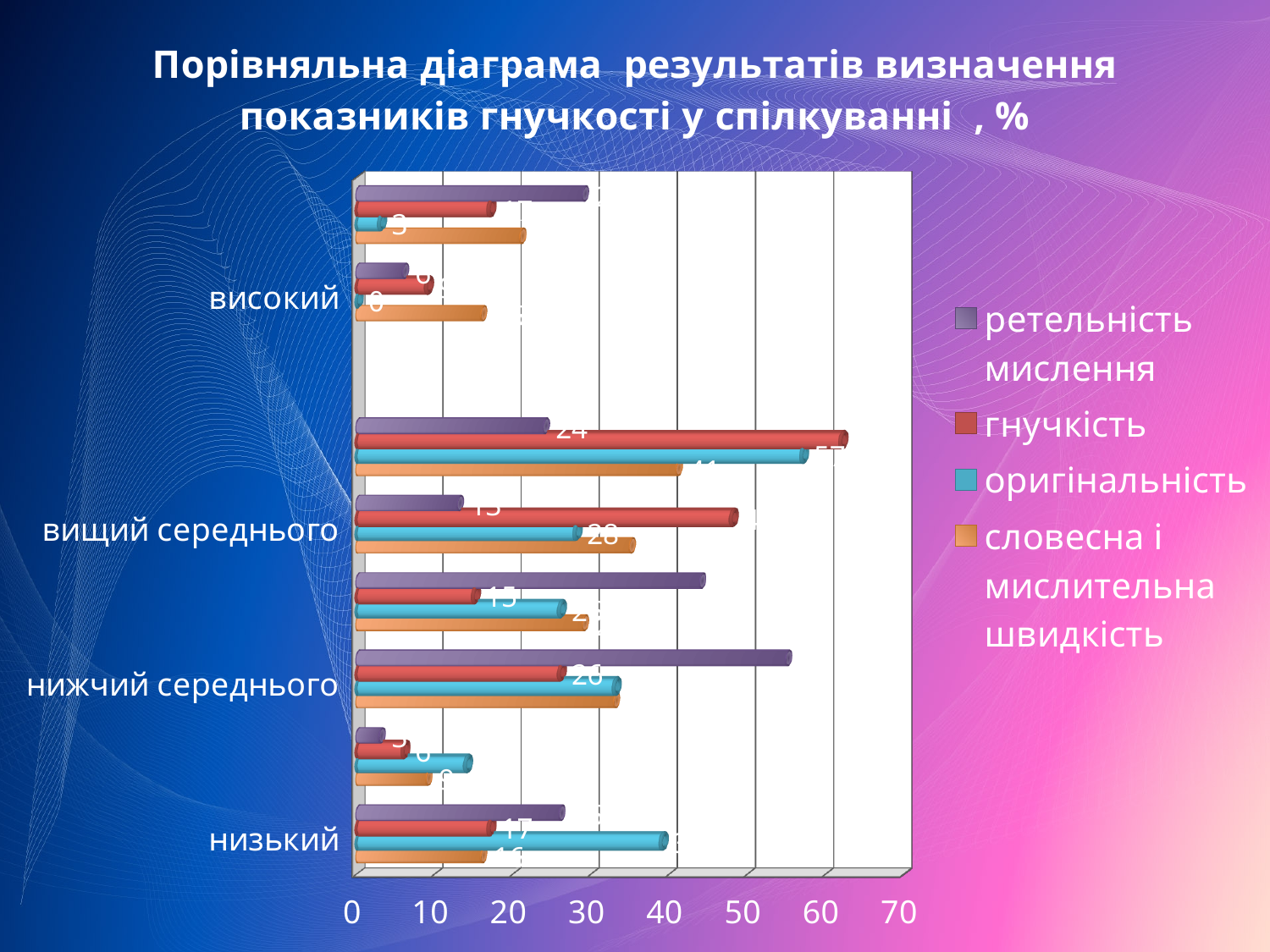
What is the value for гнучкість in the низький group? 17 What is the value for оригінальність in the вищий середнього group? 28 What is the value for оригінальність in the високий group? 0 Is the value for ретельність мислення in the нижчий середнього group greater or less than 50? greater Is the value for оригінальність in the низький group greater or less than 30? greater What is the value for гнучкість in the нижчий середнього group? 26 In the низький group, which is larger: оригінальність or гнучкість? оригінальність Which series has the longest bar on the chart? гнучкість What is the highest value shown on the horizontal axis? 70 What kind of chart is shown on the slide? bar chart How many series does the legend list? 4 In the нижчий середнього group, which is larger: ретельність мислення or гнучкість? ретельність мислення